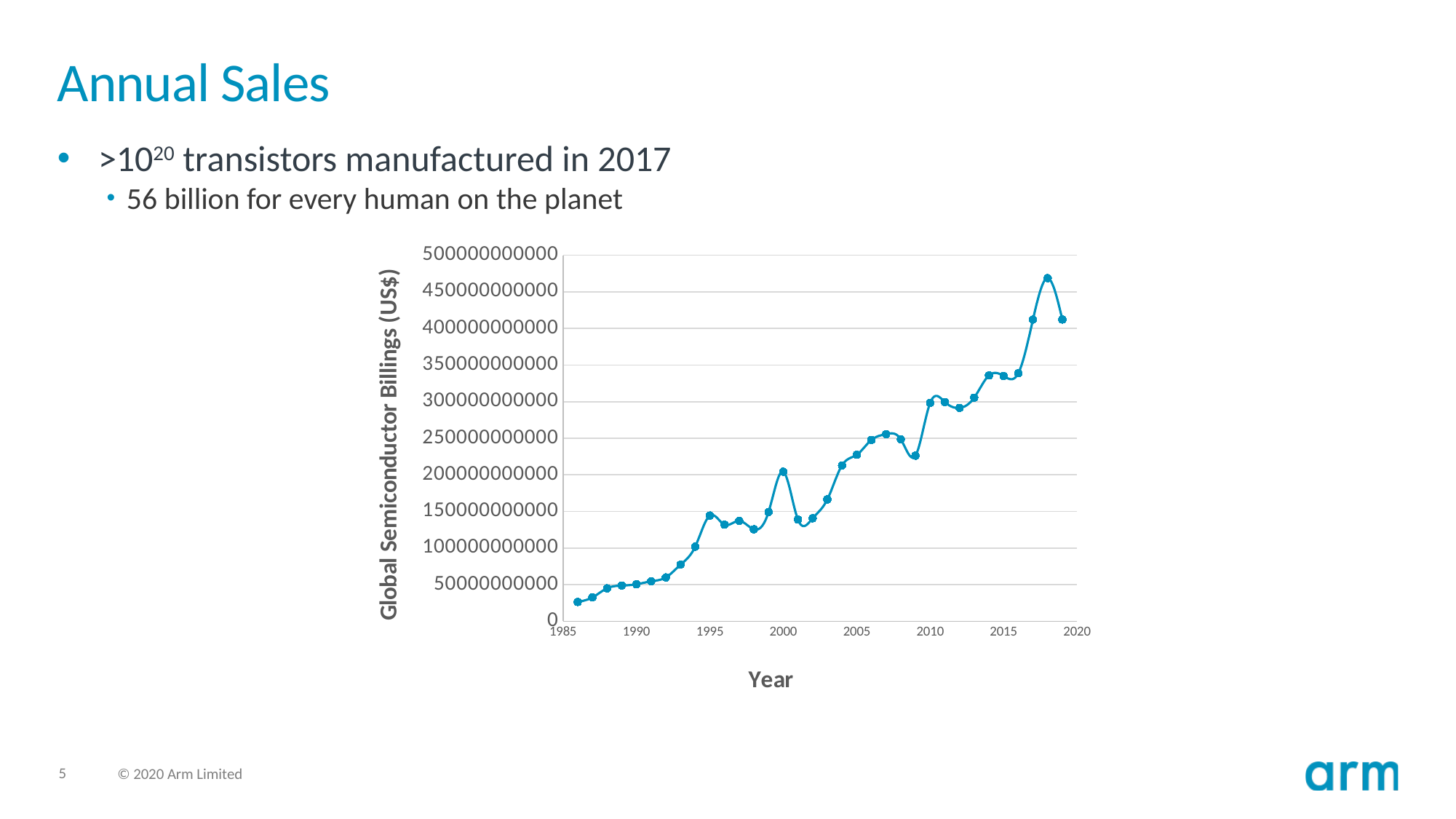
Is the value for 1986 greater or less than 50000000000? less In which year are global semiconductor billings lowest? 1986 What is the label of the horizontal axis of the chart? Year What kind of chart is shown on the slide? line chart Is the value for 2003 greater or less than 150000000000? greater Is the value for 2009 greater or less than 250000000000? less Which year has higher global semiconductor billings, 2018 or 2019? 2018 In which year do global semiconductor billings reach their highest value? 2018 Overall, do global semiconductor billings rise or fall from 1985 to 2020? rise Which year has higher global semiconductor billings, 2000 or 2001? 2000 What is the label of the vertical axis of the chart? Global Semiconductor Billings (US$)